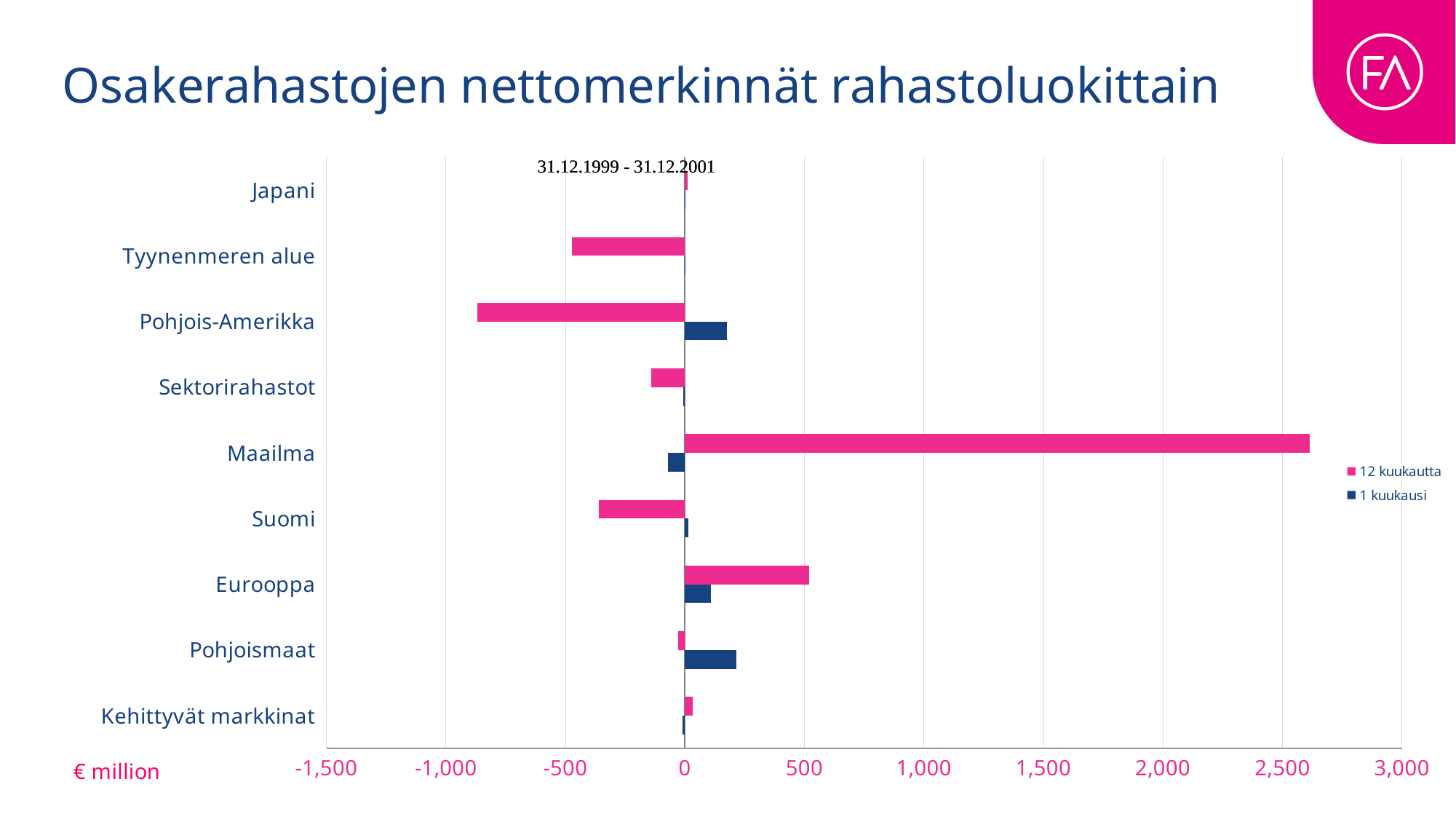
What unit is shown for the x axis? € million Is the 12 kuukautta value for Pohjois-Amerikka greater or less than -500? less How many series does the legend list? 2 How many categories are shown on the chart? 9 Which category has the lowest value for the 12 kuukautta series? Pohjois-Amerikka Which category has the highest value for the 12 kuukautta series? Maailma What kind of chart is shown on the slide? bar chart What is the title of the chart? Osakerahastojen nettomerkinnät rahastoluokittain Is the 12 kuukautta value for Suomi greater or less than 0? less Which category has the lowest value for the 1 kuukausi series? Maailma Which is larger for the 12 kuukautta series: Maailma or Eurooppa? Maailma Is the 12 kuukautta value for Maailma greater or less than 2,500? greater